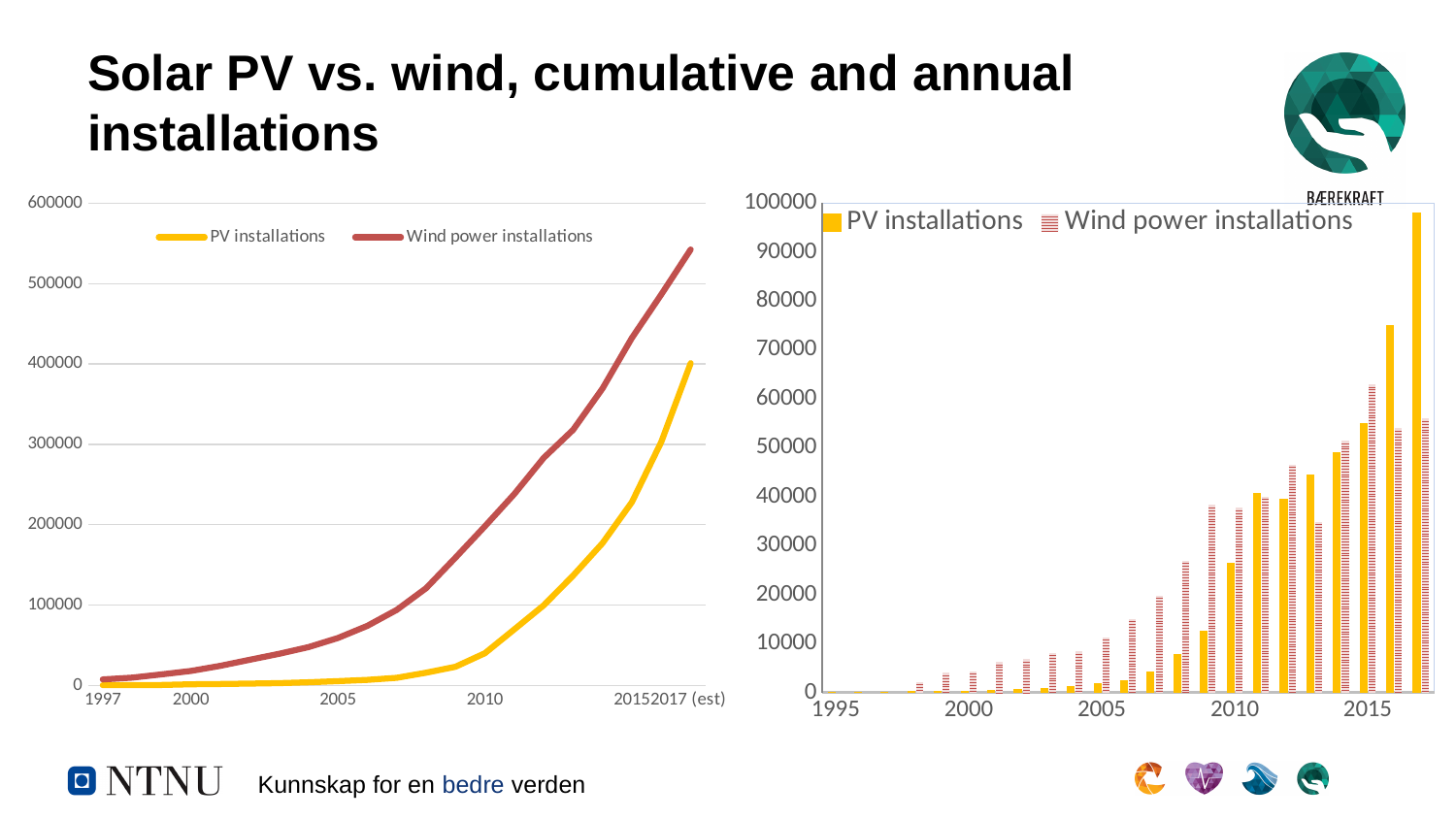
In the right chart, is the value for PV installations in 2017 greater or less than 90000? greater In the left chart, which series is higher at 2017 (est), PV installations or Wind power installations? Wind power installations How many series does the legend of the left chart list? 2 In the left chart, is the value for PV installations at 2010 greater or less than 100000? less In the left chart, is the value for Wind power installations at 2017 (est) greater or less than 500000? greater What kind of chart is the chart on the left side of the slide? line chart In the left chart, what colour is the line for PV installations? yellow In the right chart, which series has the larger bar in 2010, PV installations or Wind power installations? Wind power installations In the right chart, which series has the larger bar in 2016, PV installations or Wind power installations? PV installations In the right chart, which year has the highest PV installations bar? 2017 In the left chart, do the PV installations values rise or fall from 1997 to 2017 (est)? rise What kind of chart is the chart on the right side of the slide? bar chart